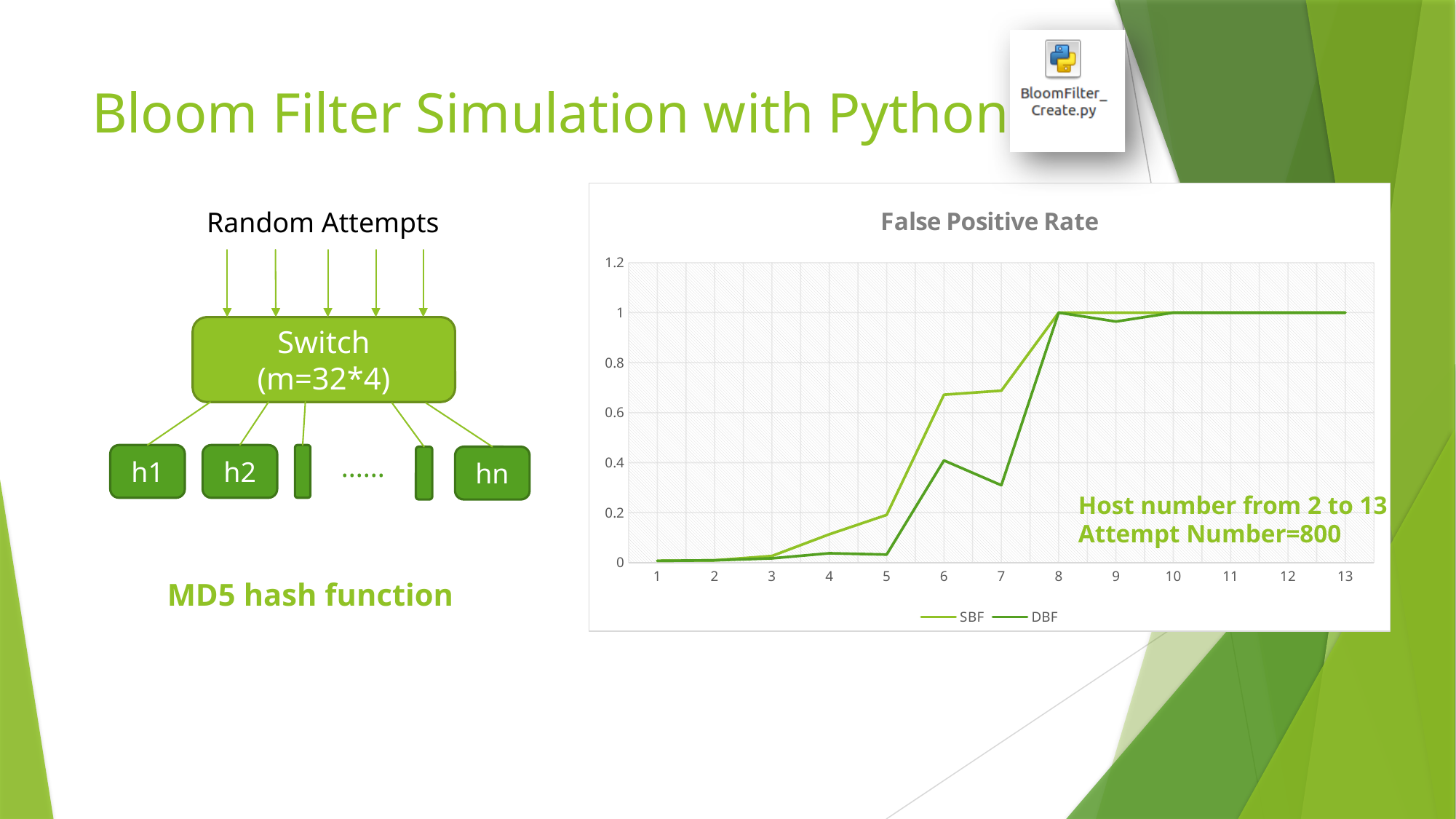
Is the DBF value at x = 6 greater or less than 0.2? greater What is the SBF value at x = 13? 1 What are the names of the two series in the legend? SBF and DBF Is the DBF value at x = 7 greater or less than 0.4? less What is the title of the chart? False Positive Rate Is the SBF value at x = 6 greater or less than 0.6? greater Do the false positive rate values generally rise or fall as x increases from 1 to 8? rise What kind of chart is shown on the slide? line chart At x = 7, which series has the higher false positive rate, SBF or DBF? SBF How many points are plotted along the x axis for each series? 13 How many series does the chart legend list? 2